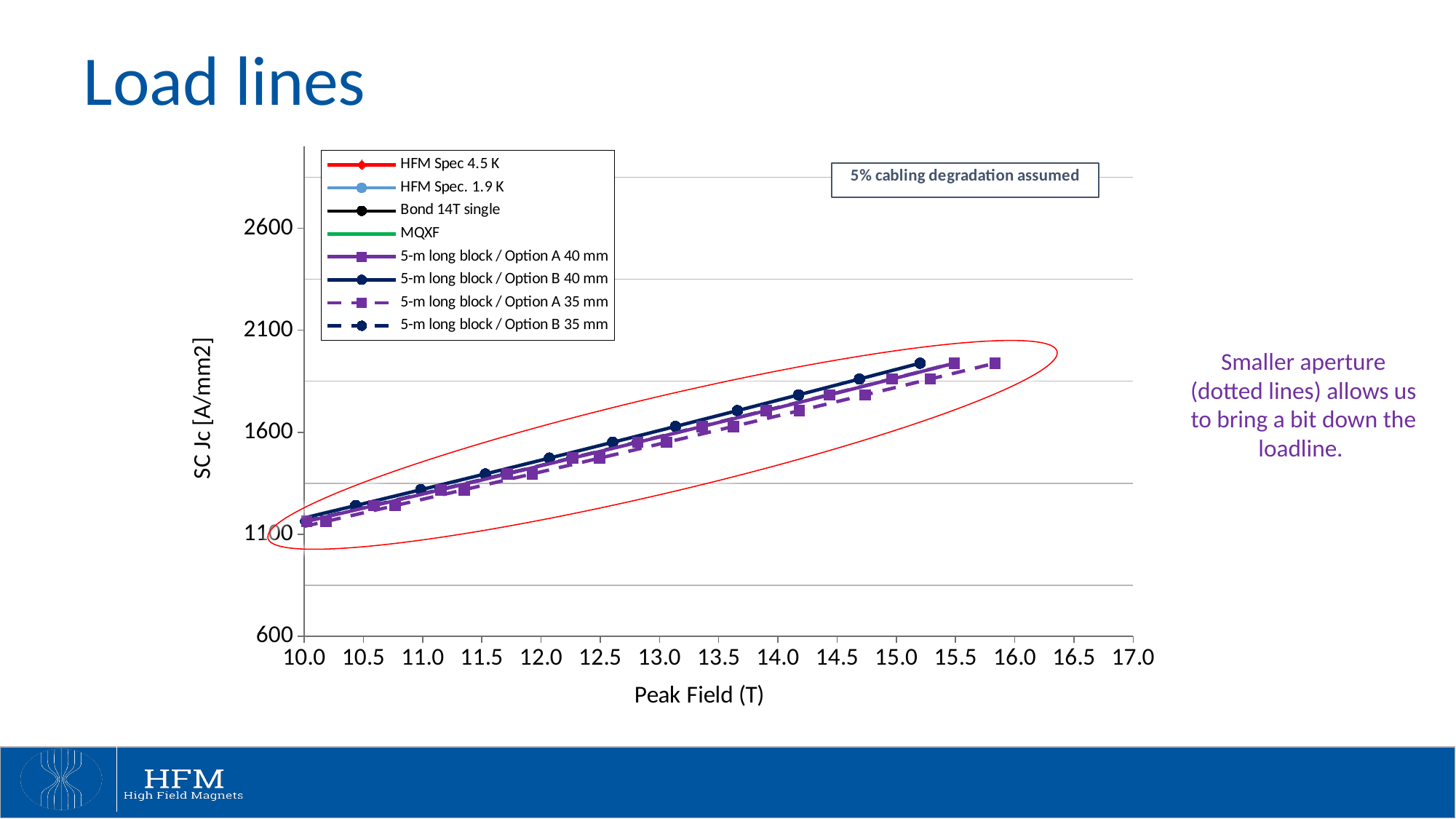
Is the value of the '5-m long block / Option A 40 mm' line at 11.0 T greater or less than 1600? less What kind of chart is shown on the slide? Line chart Is the value of the '5-m long block / Option B 40 mm' line at 14.0 T greater or less than 1600? greater Are all plotted load lines below 2100 A/mm2 across the shown range? Yes What is the title of the chart on the slide? Load lines How many series does the legend list? 8 What assumption is stated in the text box inside the chart? 5% cabling degradation assumed Do the plotted load lines rise or fall as Peak Field increases? Rise Which plotted series extends to the highest Peak Field value? 5-m long block / Option A 35 mm